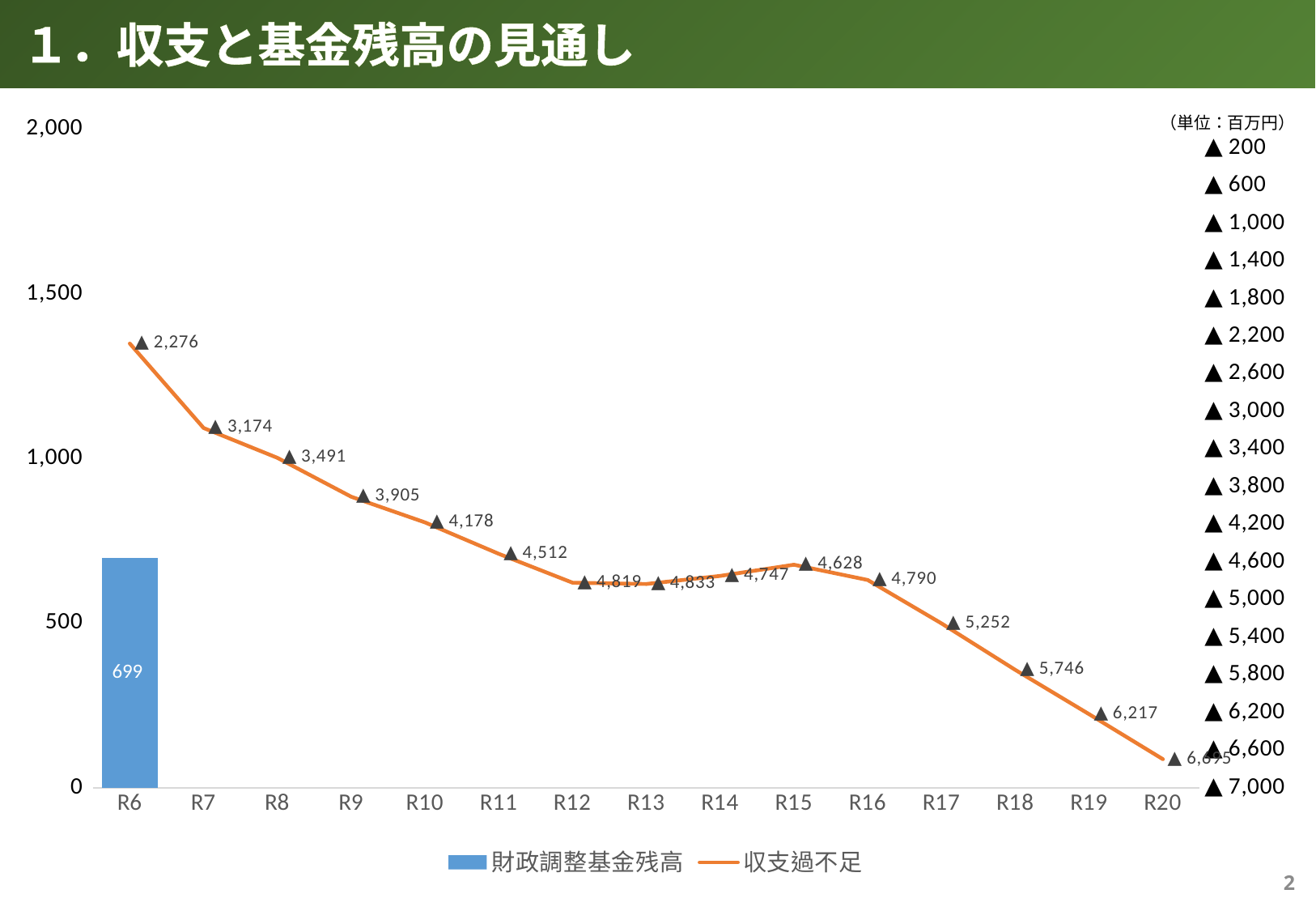
What is the 収支過不足 value labelled at R19? ▲6,217 What is the 収支過不足 value labelled at R17? ▲5,252 What is the 収支過不足 value labelled at R11? ▲4,512 By how much does the 収支過不足 figure at R7 (▲3,174) exceed the figure at R6 (▲2,276) in magnitude? 898 How many year categories are shown on the x axis? 15 What is the value of 財政調整基金残高 for R6? 699 Which year has the smallest 収支過不足 magnitude on the line? R6 What unit is stated for the chart values? 百万円 Does the 収支過不足 line generally rise or fall from R6 to R20? Fall How many series does the legend list? 2 What is the 収支過不足 value labelled at R6? ▲2,276 What kind of chart is this? Combined bar and line chart